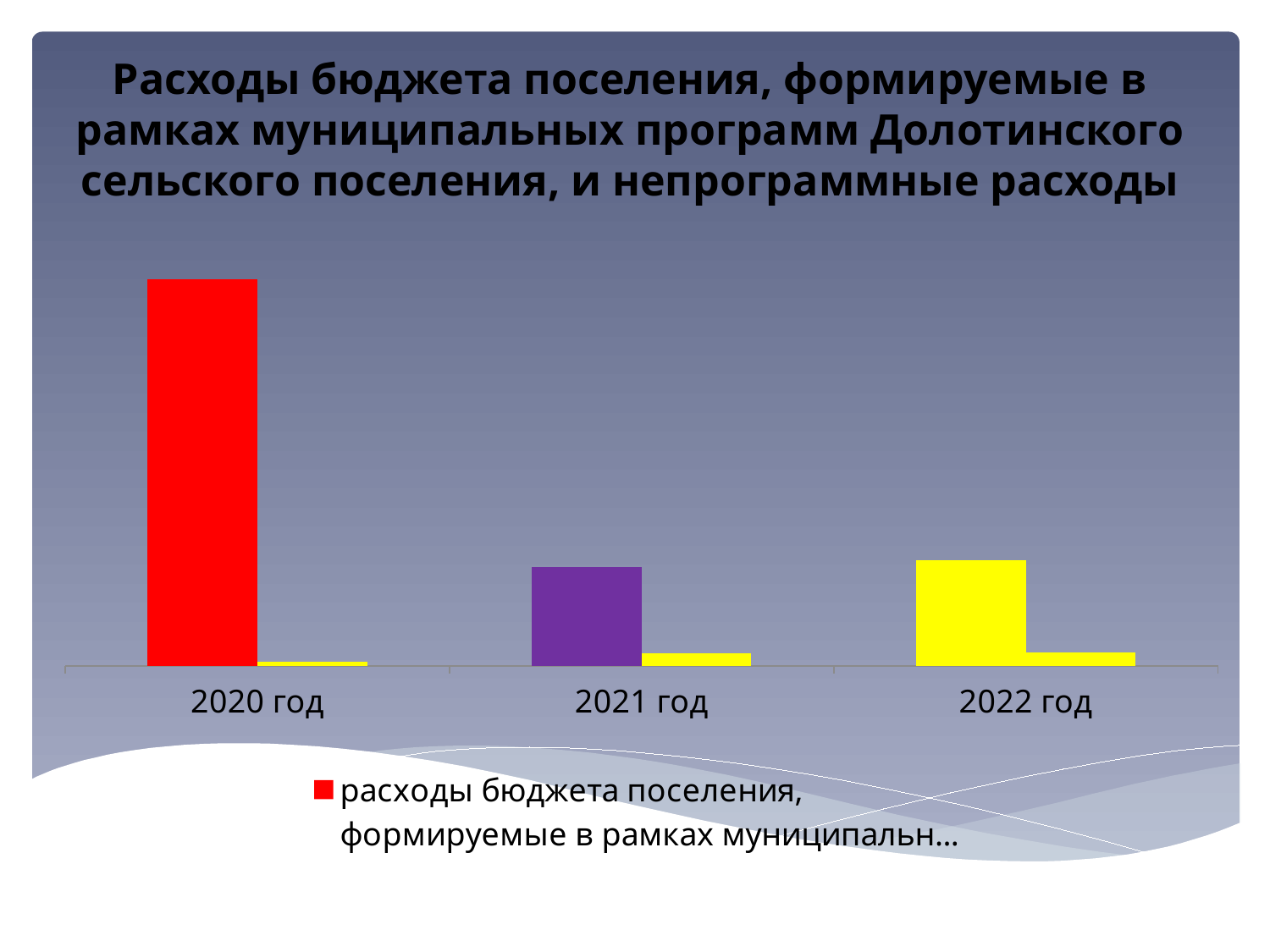
Does the tall bar fall or rise from 2020 год to 2021 год? fall What kind of chart is shown on the slide? bar chart How many entries does the legend list? 1 Which is larger: the tall bar for 2020 год or the tall bar for 2021 год? 2020 год What are the category labels on the x axis of the chart? 2020 год, 2021 год, 2022 год Which year has the tallest bar in the chart? 2020 год How many categories are shown on the x axis of the chart? 3 What colour is the tall bar for 2020 год? red